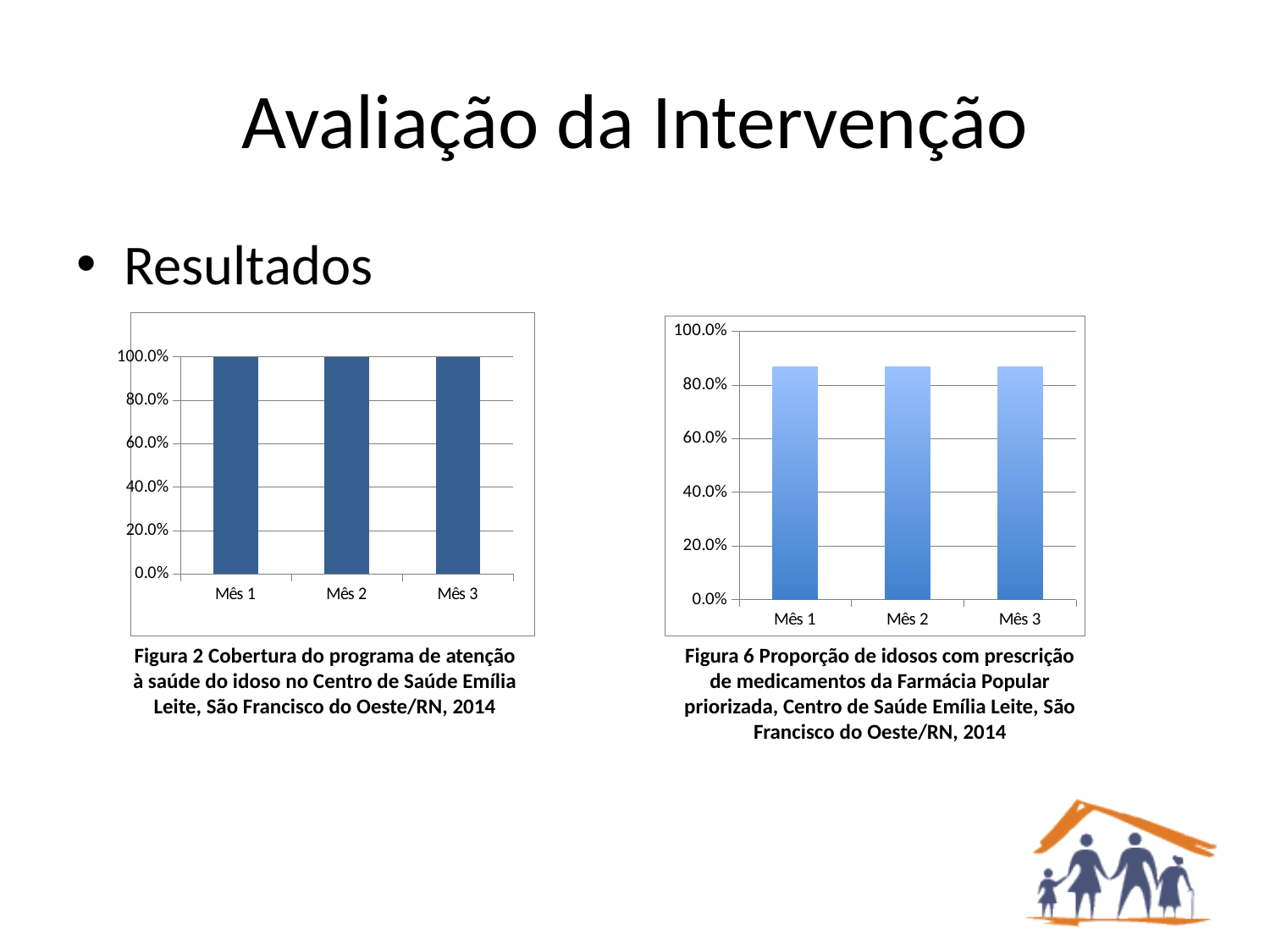
In the left chart (Figura 2), how many categories are shown on the x axis? 3 In the right chart (Figura 6), is the value for Mês 2 greater or less than 100.0%? less What is the label of the first category on the x axis of the left chart (Figura 2)? Mês 1 In the right chart (Figura 6), do the values rise, fall or stay roughly the same across Mês 1 to Mês 3? stay roughly the same In the right chart (Figura 6), is the value for Mês 3 greater or less than 60.0%? greater In the left chart (Figura 2), do the values rise, fall or stay the same from Mês 1 to Mês 3? stay the same What kind of chart is the right chart (Figura 6)? bar chart In the right chart (Figura 6), is the value for Mês 1 greater or less than 80.0%? greater What kind of chart is the left chart (Figura 2)? bar chart In the right chart (Figura 6), how many bars are plotted? 3 In the left chart (Figura 2), what is the value for Mês 1? 100.0%